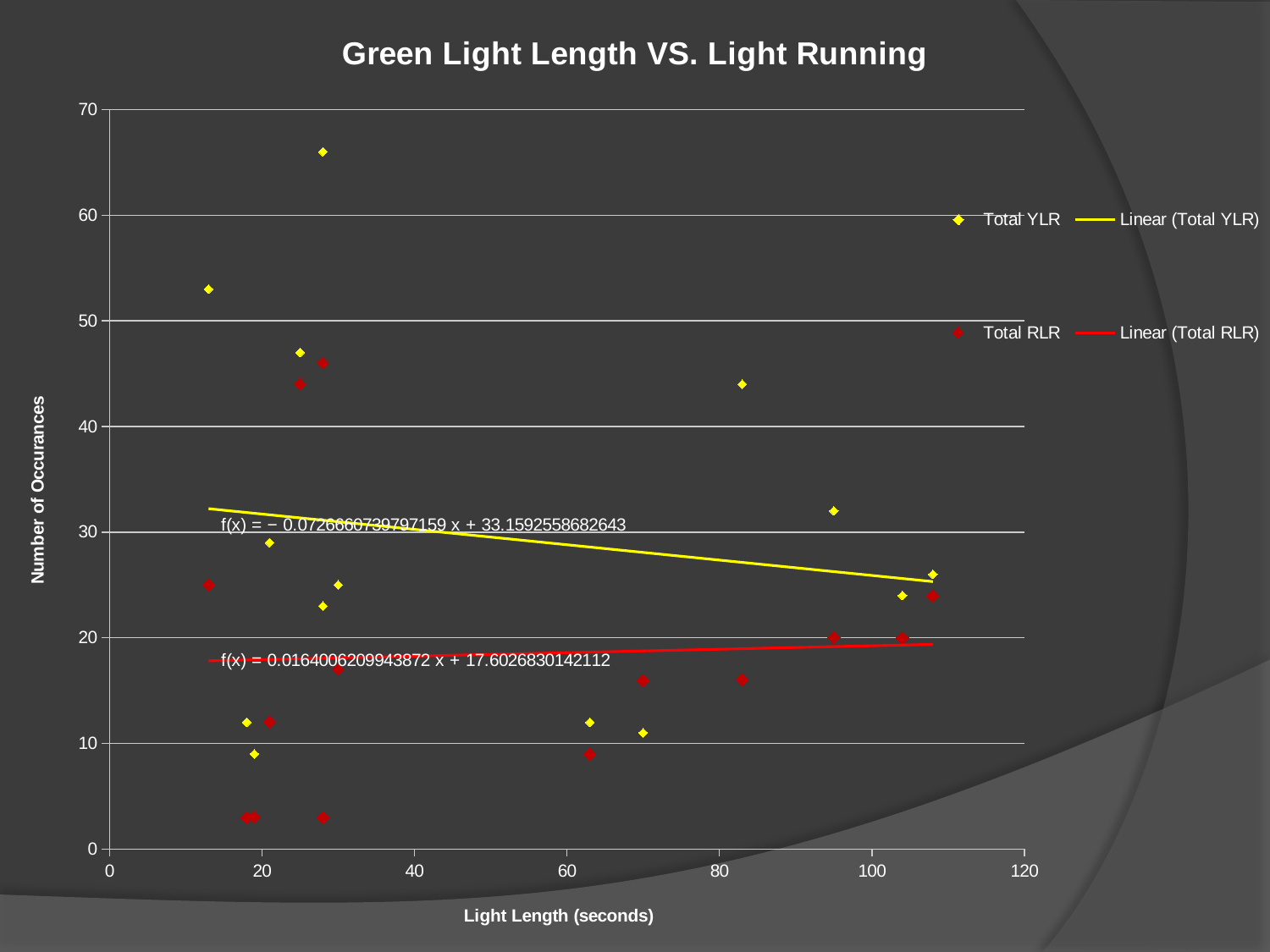
What is the highest value shown on the y axis? 70 What is the label of the x axis? Light Length (seconds) Is the lowest Total RLR point greater or less than 10? less What kind of chart is shown on the slide? scatter chart What is the title of the chart? Green Light Length VS. Light Running Does the Linear (Total YLR) trendline rise or fall as light length increases? fall Does the Linear (Total RLR) trendline rise or fall as light length increases? rise Is the highest Total YLR point greater or less than 60? greater How many entries does the chart's legend list? 4 Which series contains the single highest plotted point, Total YLR or Total RLR? Total YLR Is the intercept of the Linear (Total YLR) trendline greater or less than the intercept of the Linear (Total RLR) trendline? greater Is the highest Total RLR point greater or less than 50? less